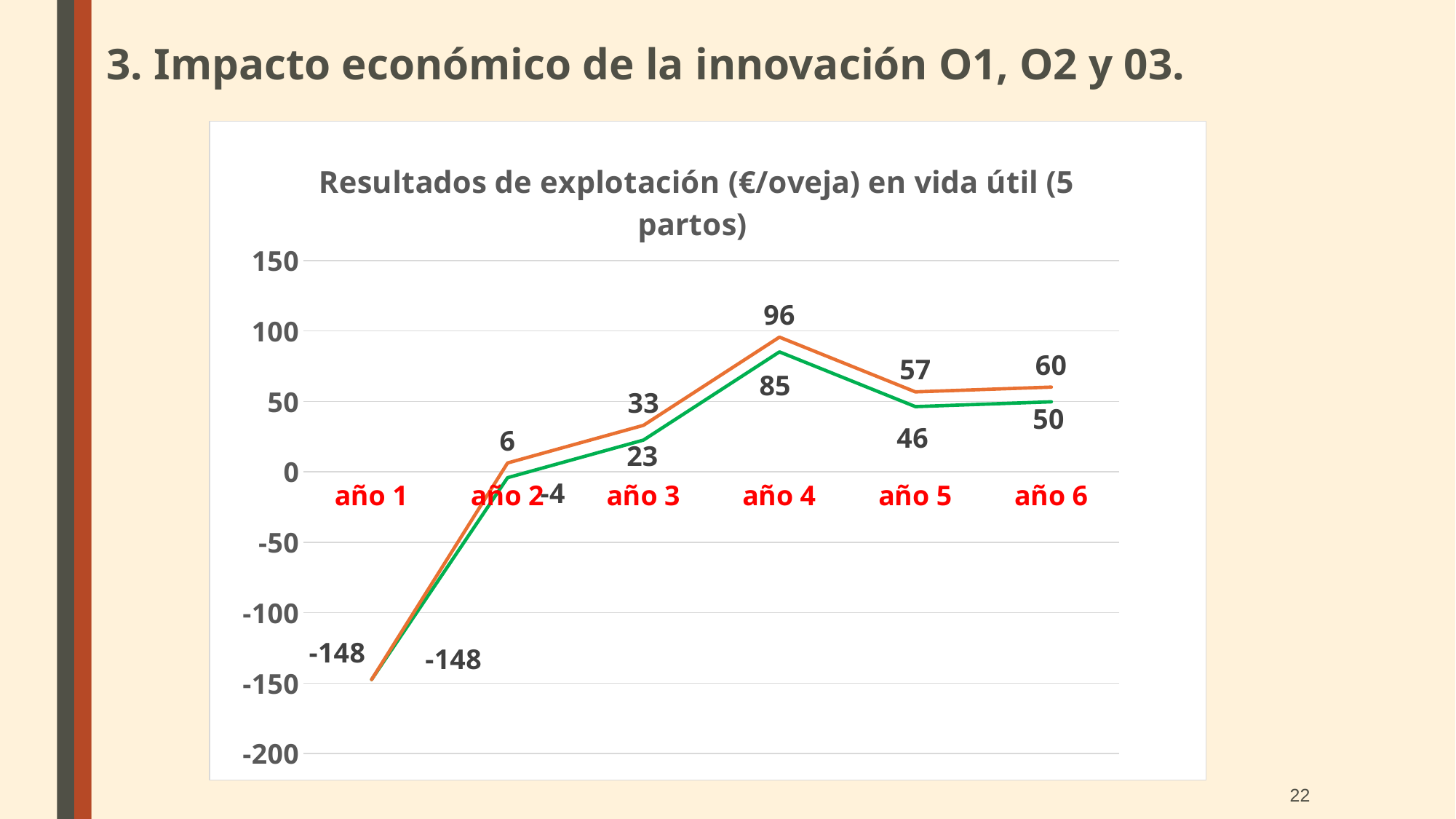
In which year does the green line have its lowest value? año 1 What is the value of the green line at año 2? -4 What is the value of the orange line at año 4? 96 Do the values of the orange line rise or fall from año 1 to año 4? rise What is the difference between the orange line and the green line at año 3? 10 How many years (categories) are plotted along the x axis? 6 What is the title of the chart? Resultados de explotación (€/oveja) en vida útil (5 partos) Which is larger at año 5: the orange line value or the green line value? the orange line (57) What type of chart is shown on the slide? line chart In which year does the orange line reach its highest value? año 4 What is the value of the orange line at año 6? 60 What is the value of the green line at año 4? 85